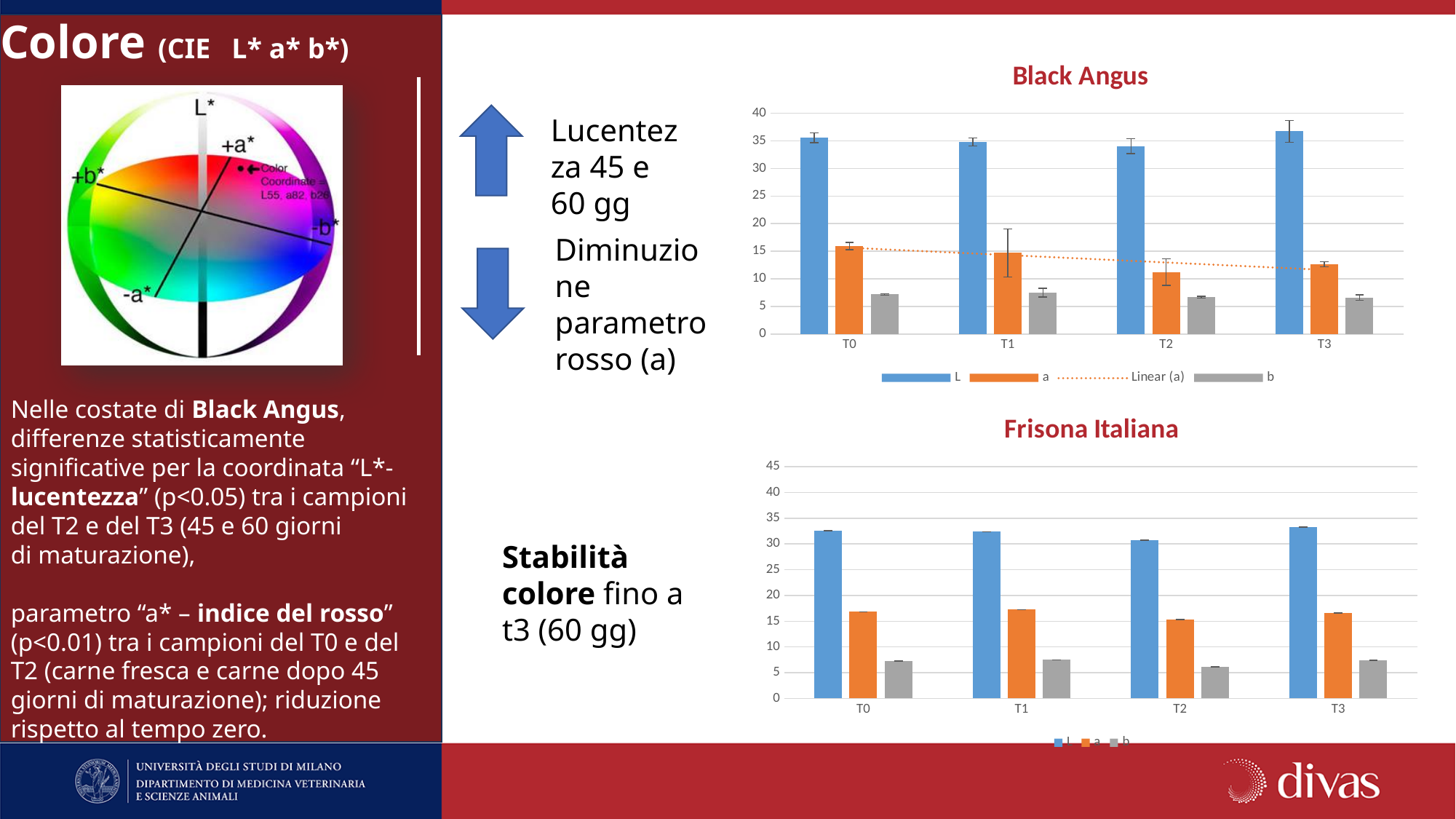
In the Black Angus chart, at which time point is the value of a lowest? T2 How many entries does the legend of the Black Angus chart list? 4 In the Frisona Italiana chart, is the value of a at T2 greater or less than 20? less In the Black Angus chart, is the value of L at T0 greater or less than 30? greater How many time points (categories) are shown on the x axis of the Frisona Italiana chart? 4 In the Frisona Italiana chart, is the value of L at T0 greater or less than 30? greater What kind of chart is the Black Angus chart? bar chart In the Black Angus chart, which is larger at T0, L or a? L In the Frisona Italiana chart, at which time point is the value of L lowest? T2 In the Black Angus chart, does the Linear (a) trendline rise or fall from T0 to T3? fall